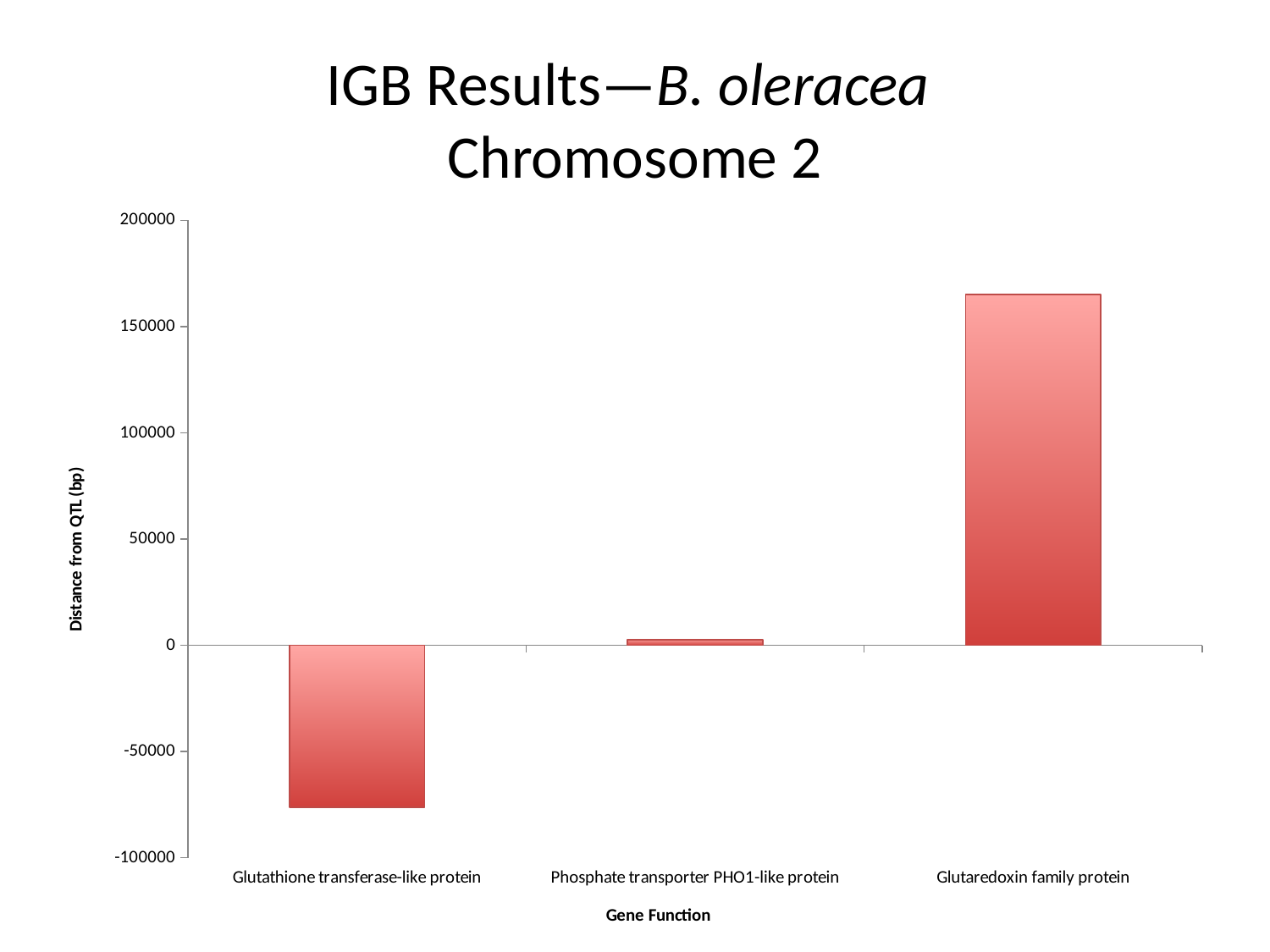
Is the value for Glutaredoxin family protein greater or less than 150000? greater What kind of chart is shown on the slide? bar chart What is the label of the y axis? Distance from QTL (bp) What is the label of the x axis? Gene Function Is the value for Glutathione transferase-like protein greater or less than -50000? less Which gene function has the lowest distance from QTL? Glutathione transferase-like protein Which is larger, the value for Phosphate transporter PHO1-like protein or the value for Glutathione transferase-like protein? Phosphate transporter PHO1-like protein Which gene function has the highest distance from QTL? Glutaredoxin family protein How many gene function categories are plotted on the chart? 3 Is the value for Phosphate transporter PHO1-like protein greater or less than 50000? less Which is larger, the value for Glutaredoxin family protein or the value for Phosphate transporter PHO1-like protein? Glutaredoxin family protein